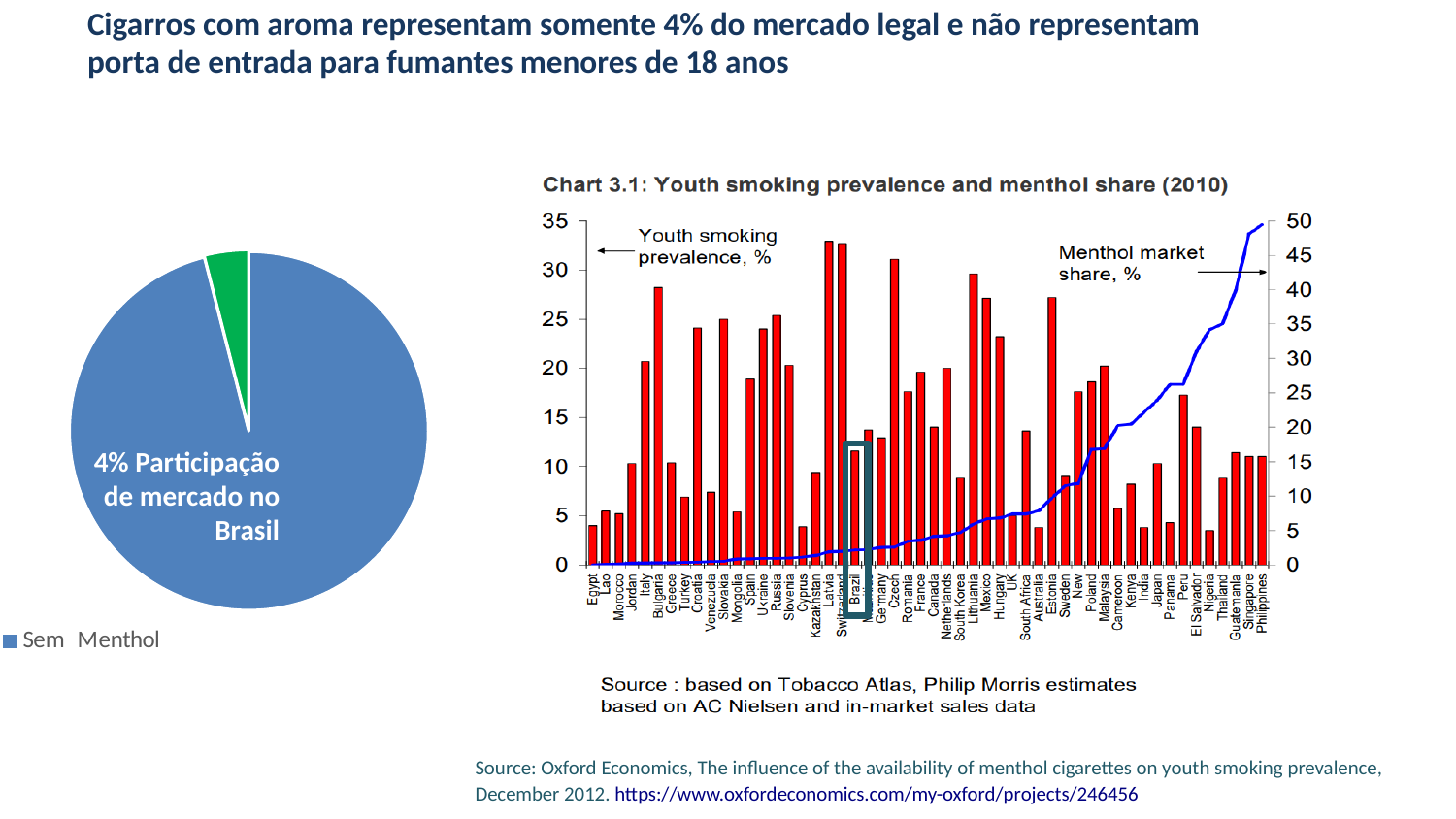
What is the title of the chart on the right of the slide? Chart 3.1: Youth smoking prevalence and menthol share (2010) In Chart 3.1, is the youth smoking prevalence for Brazil greater or less than 10? greater What kind of chart is the chart on the left of the slide? pie chart In Chart 3.1, which country's bar is highlighted with a box? Brazil In Chart 3.1, is the menthol market share for the Philippines greater or less than 45? greater In Chart 3.1, is the youth smoking prevalence for Bulgaria greater or less than 25? greater In Chart 3.1, which has the higher youth smoking prevalence, Czech or Brazil? Czech How many slices does the pie chart on the left have? 2 In the pie chart on the left, what share of the Brazilian market do menthol cigarettes hold? 4% In Chart 3.1, how many data series are plotted? 2 In Chart 3.1, does the menthol market share line rise or fall from left to right along the x axis? rise